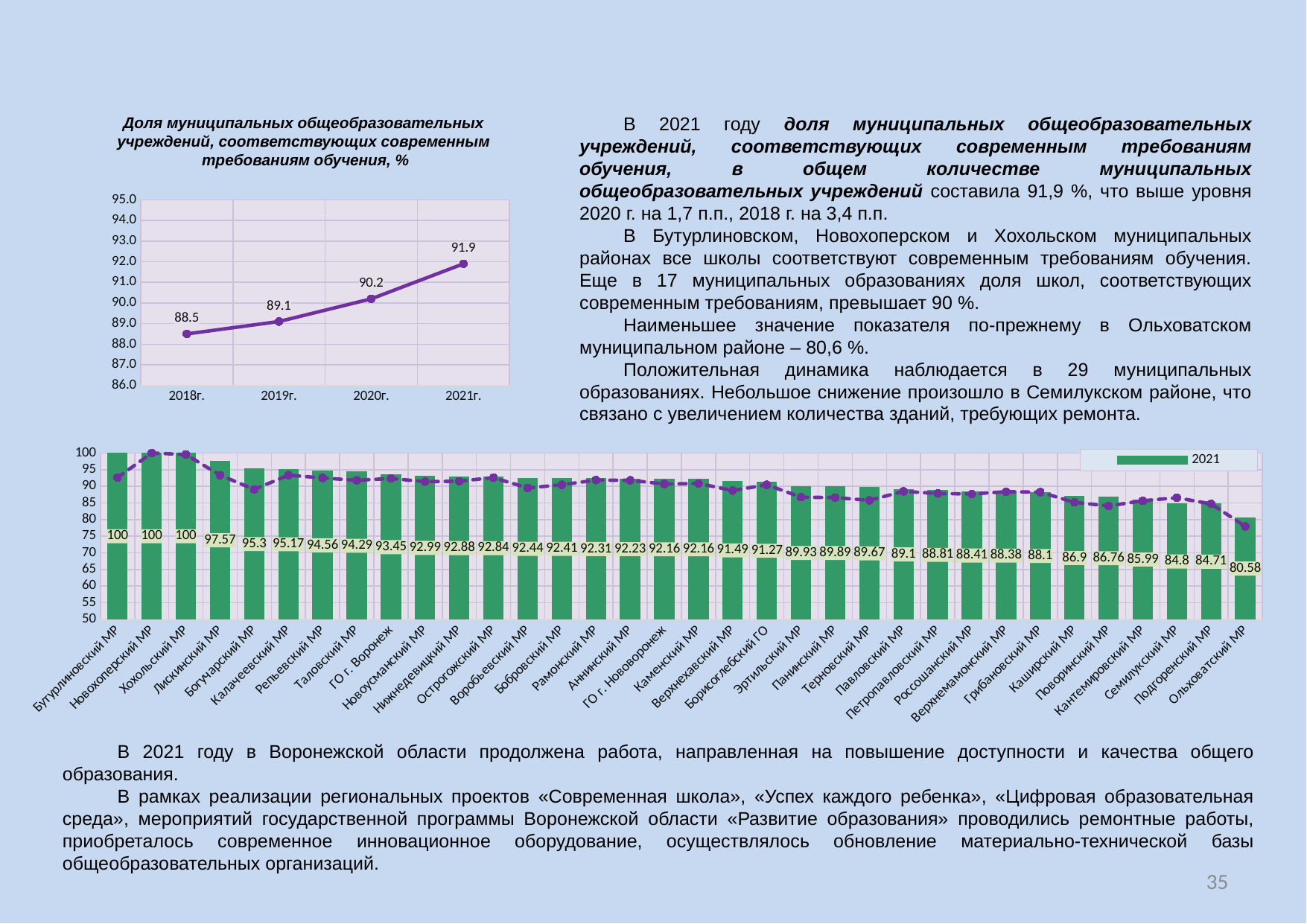
In the top-left line chart, what is the value for 2018г.? 88.5 In the bottom bar chart, what is the difference between the 2021 values for Богучарский МР and Семилукский МР? 10.5 In the top-left line chart, how many years are plotted? 4 In the top-left line chart, what is the value for 2021г.? 91.9 In the bottom bar chart, what is the 2021 value for Ольховатский МР? 80.58 In the top-left line chart, do the values rise or fall from 2018г. to 2021г.? rise In the bottom bar chart, what is the 2021 value for Лискинский МР? 97.57 In the bottom bar chart, what series name does the legend show? 2021 In the bottom bar chart, which category has the lowest 2021 value? Ольховатский МР What kind of chart is the top-left chart? line chart In the top-left line chart, by how much does the value for 2021г. exceed the value for 2020г.? 1.7 In the bottom bar chart, which has the larger 2021 value, Каширский МР or Таловский МР? Таловский МР